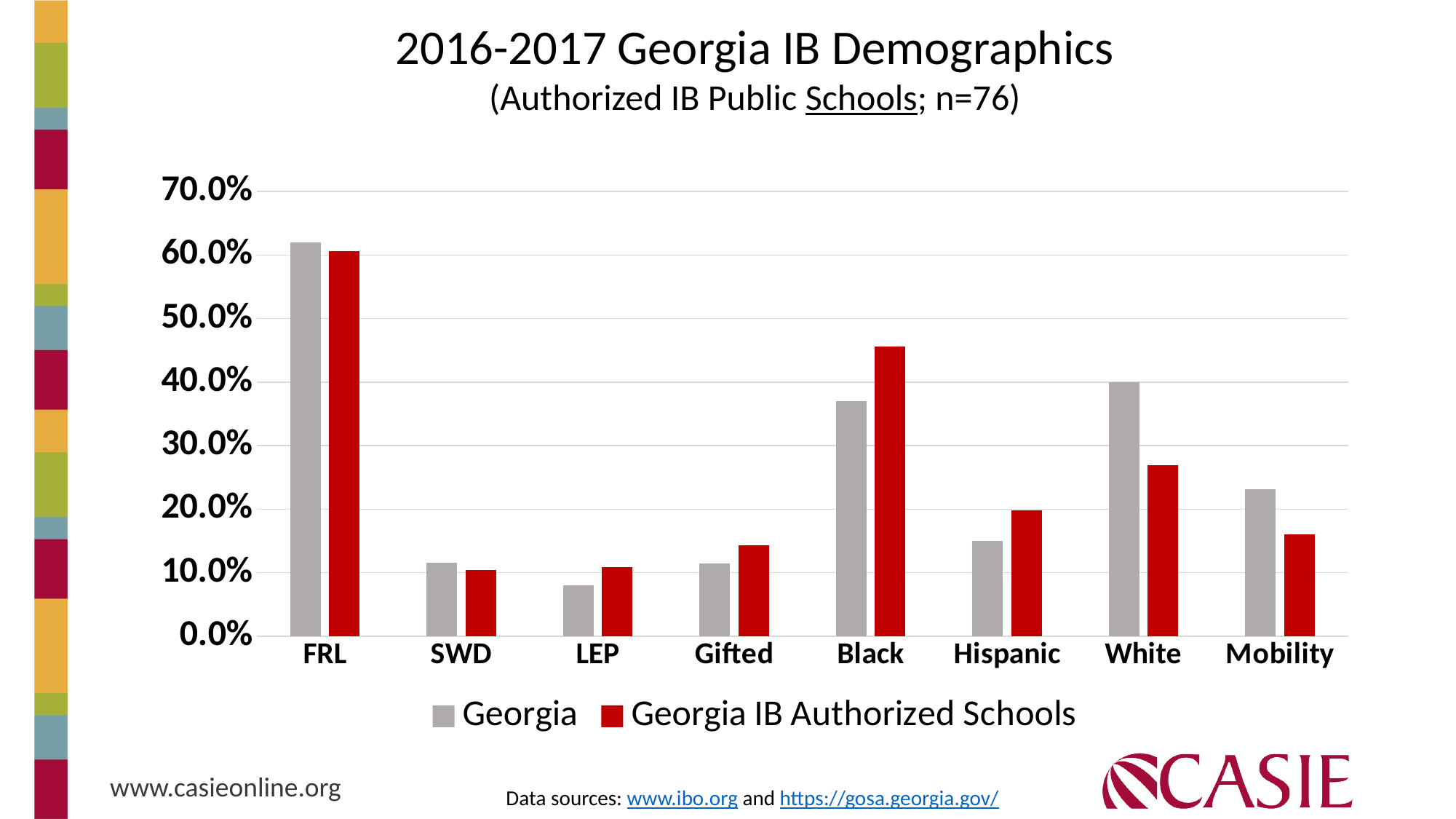
What kind of chart is shown on the slide? bar chart How many series does the legend list? 2 Which category has the highest value for the Georgia IB Authorized Schools series? FRL For the Black category, which series has the larger value, Georgia or Georgia IB Authorized Schools? Georgia IB Authorized Schools What is the title of the chart? 2016-2017 Georgia IB Demographics (Authorized IB Public Schools; n=76) Is the Georgia value for LEP greater or less than 10.0%? less Is the Georgia IB Authorized Schools value for Black greater or less than 40.0%? greater Which category has the highest value for the Georgia series? FRL Is the Georgia IB Authorized Schools value for White greater or less than 30.0%? less How many categories are shown on the x axis? 8 For the White category, which series has the larger value, Georgia or Georgia IB Authorized Schools? Georgia Which category has the lowest value for the Georgia series? LEP